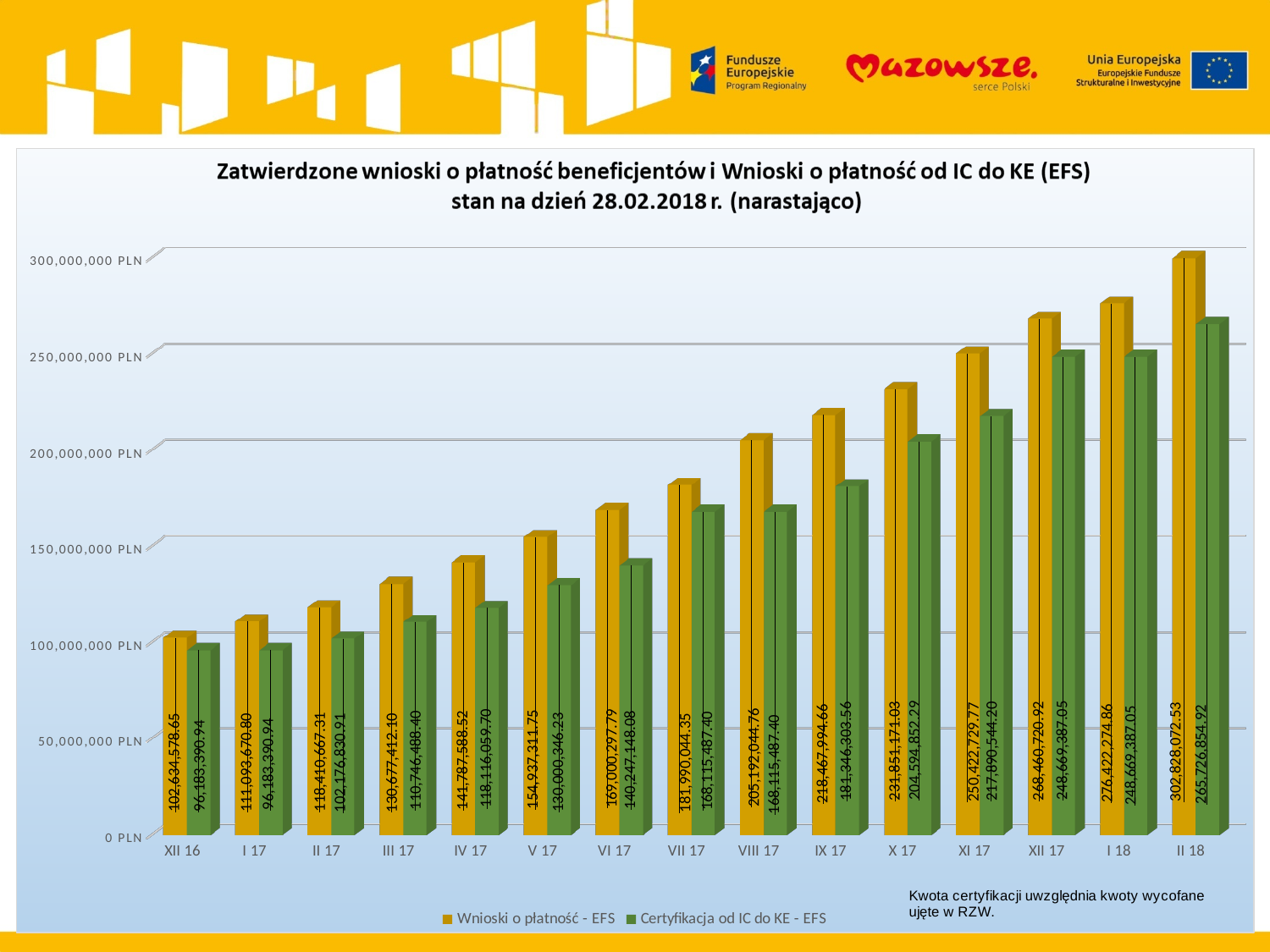
Which period has the lowest value for 'Certyfikacja od IC do KE - EFS'? XII 16 and I 17 (both 96,183,390.94) What is the difference between 'Wnioski o płatność - EFS' and 'Certyfikacja od IC do KE - EFS' for II 18? 37,101,217.61 How many time periods are shown on the x axis? 15 How many series does the legend list? 2 Which period has the highest value for 'Wnioski o płatność - EFS'? II 18 What type of chart is shown on the slide? bar chart What is the value of 'Certyfikacja od IC do KE - EFS' for XI 17? 217,890,544.20 Which is larger for X 17: 'Wnioski o płatność - EFS' or 'Certyfikacja od IC do KE - EFS'? Wnioski o płatność - EFS What is the value of 'Wnioski o płatność - EFS' for V 17? 154,937,311.75 What is the value of 'Wnioski o płatność - EFS' for II 18? 302,828,072.53 Do the values of 'Wnioski o płatność - EFS' rise or fall from XII 16 to II 18? rise Is the value of 'Wnioski o płatność - EFS' for II 18 greater or less than 300,000,000 PLN? greater